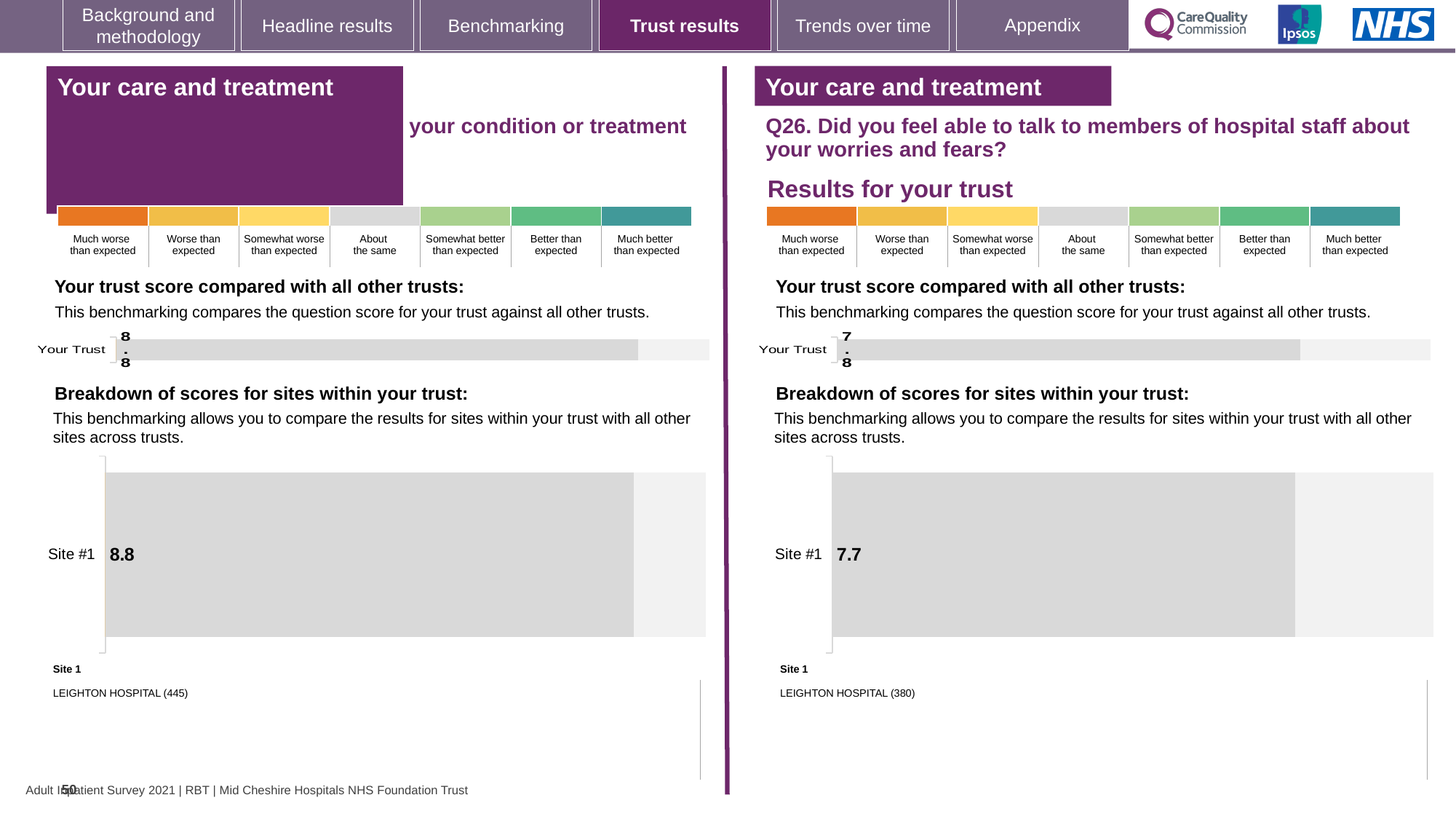
On the left half of the slide, what is the value shown for Your Trust in the 'Your trust score compared with all other trusts' chart? 8.8 On the right half of the slide (Q26), what is the value shown for Your Trust in the 'Your trust score compared with all other trusts' chart? 7.8 What type of chart is used to show the Site #1 score on the left half of the slide? Bar chart On the right half of the slide (Q26), what is the difference between the Your Trust score and the Site #1 score? 0.1 What is the difference between the Site #1 score on the left half of the slide and the Site #1 score on the right half (Q26)? 1.1 On the left half of the slide, what is the score shown for Site #1 in the breakdown of scores for sites within your trust? 8.8 How many sites are shown in the breakdown of scores chart on the right half of the slide (Q26)? 1 Which hospital is listed as Site 1 on the right half of the slide (Q26)? LEIGHTON HOSPITAL (380) Which is larger: the Site #1 score on the left half of the slide or the Site #1 score on the right half (Q26)? Left half (8.8) What is the difference between the Your Trust score on the left half of the slide and the Your Trust score on the right half (Q26)? 1.0 On the right half of the slide (Q26), what is the score shown for Site #1 in the breakdown of scores for sites within your trust? 7.7 What question number is shown in the title of the right half of the slide? Q26